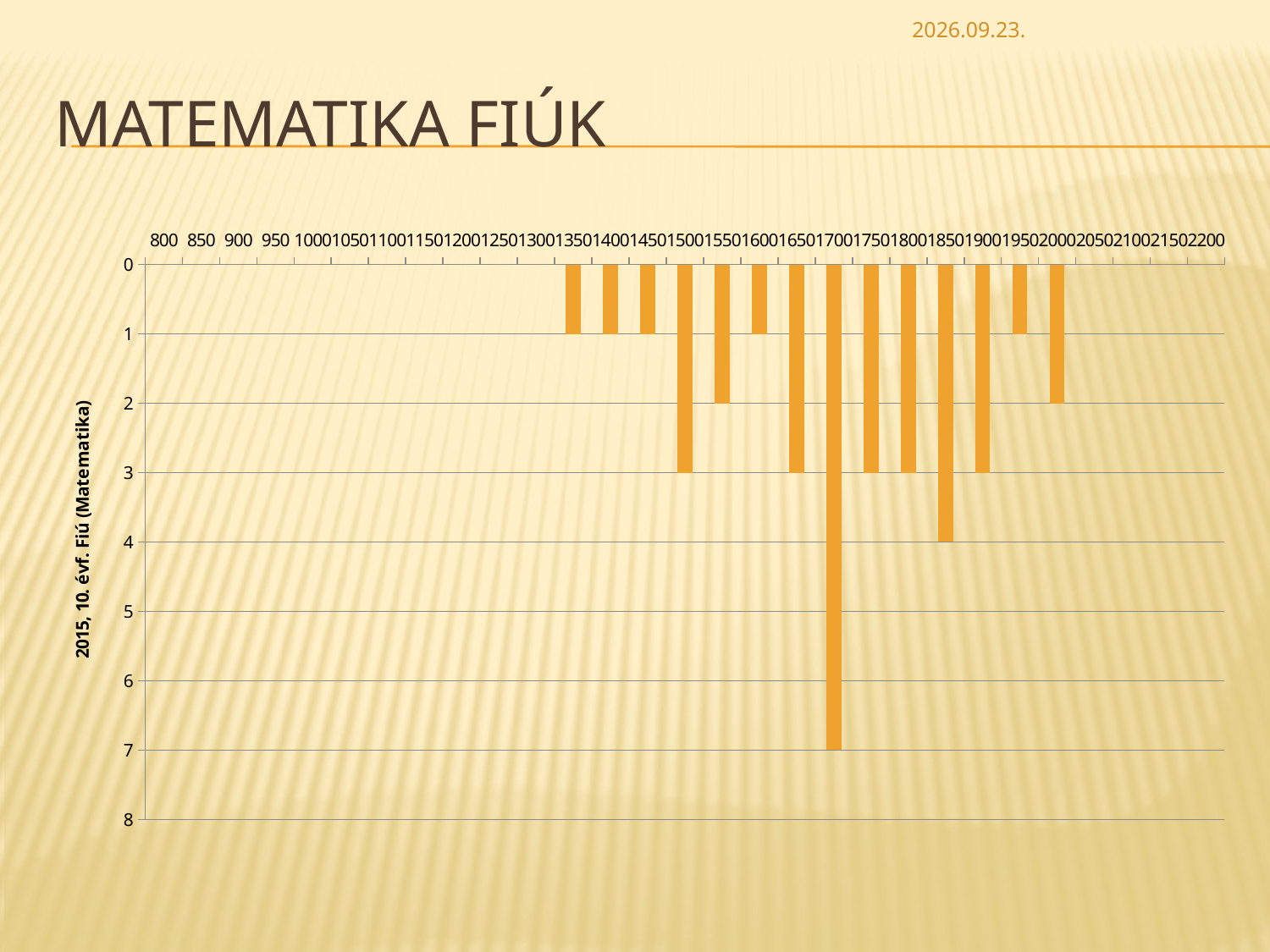
What is the value of the bar at 2000? 2 What is the title of the slide? MATEMATIKA FIÚK Which x-axis category has the tallest bar? 1700 Which is larger, the value at 1850 or the value at 1900? 1850 What kind of chart is shown on the slide? bar chart What is the label on the vertical axis? 2015, 10. évf. Fiú (Matematika) What is the value of the bar at 1850? 4 What is the value of the bar at 1700? 7 What is the difference between the values at 1500 and 1950? 2 How many bars are plotted in the chart? 14 What is the difference between the values at 1700 and 1850? 3 What is the value of the bar at 1550? 2